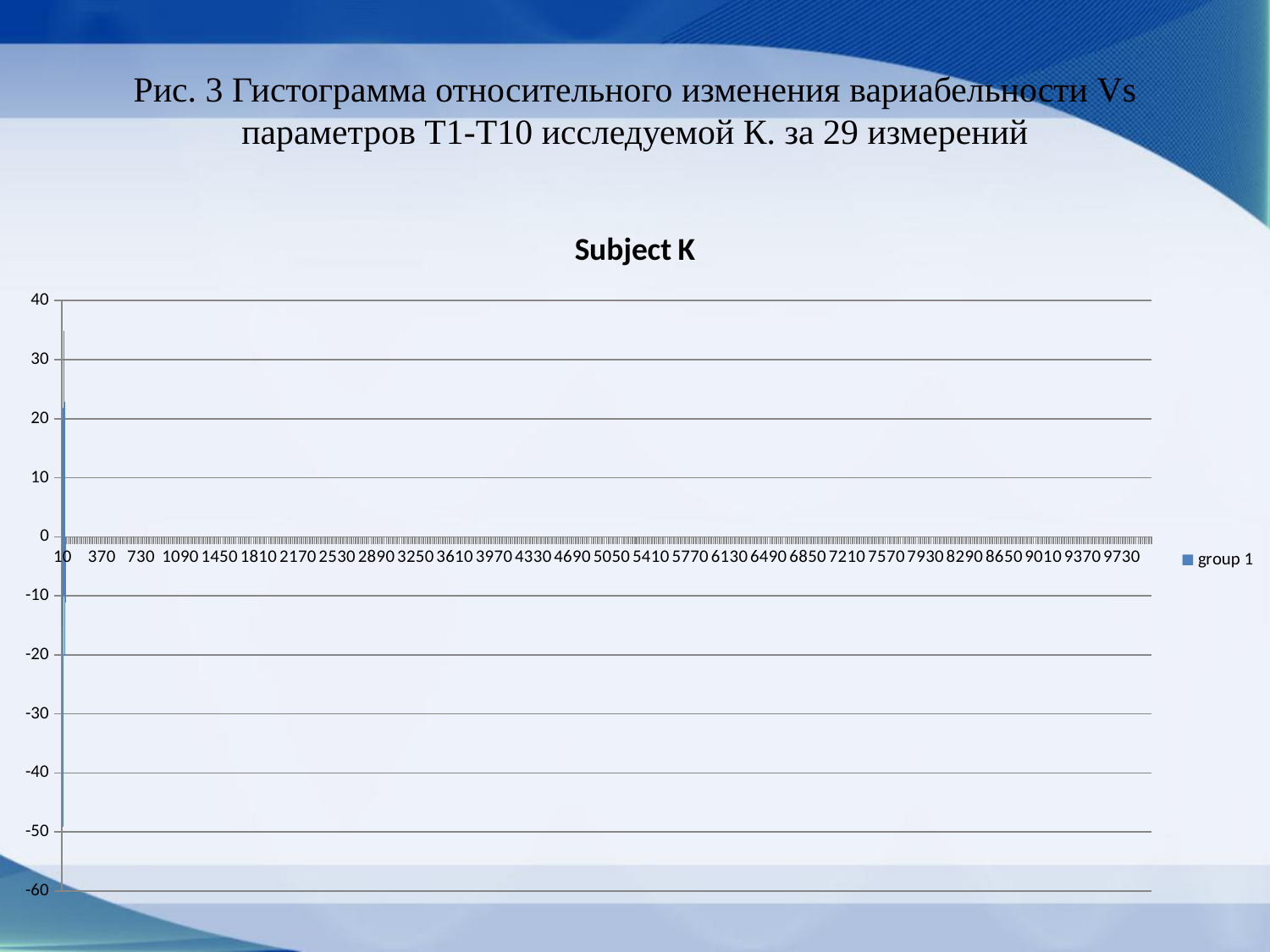
Is the highest value plotted in the chart greater or less than 40? less What is the name of the series shown in the chart legend? group 1 Is the lowest value plotted in the chart greater or less than -60? greater How many series does the legend of the chart list? 1 Is the lowest value plotted in the chart greater or less than -40? less What kind of chart is shown on the slide? bar chart What is the title of the chart? Subject K